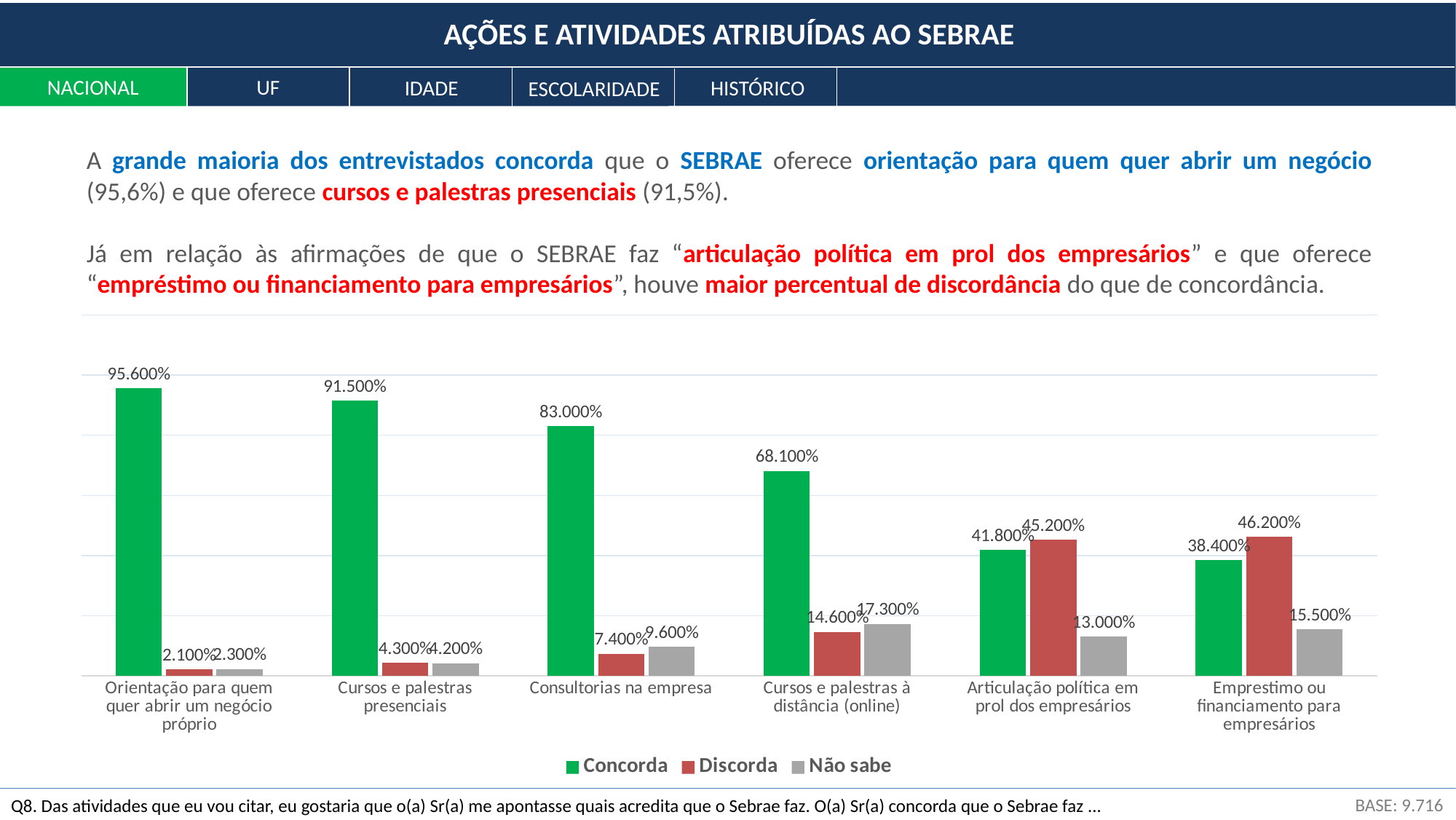
What is the Não sabe value for "Cursos e palestras à distância (online)"? 17.300% Which category has the highest Concorda value? Orientação para quem quer abrir um negócio próprio How many series does the legend list? 3 For "Articulação política em prol dos empresários", which is larger: the Concorda value or the Discorda value? Discorda What is the Concorda value for "Consultorias na empresa"? 83.000% Which category has the lowest Concorda value? Emprestimo ou financiamento para empresários What is the Discorda value for "Emprestimo ou financiamento para empresários"? 46.200% What type of chart is shown on the slide? bar chart What is the difference between the Concorda values for "Orientação para quem quer abrir um negócio próprio" and "Cursos e palestras presenciais"? 4.100% How many categories are shown on the x axis of the chart? 6 Do the Concorda values rise or fall from left to right along the x axis? fall Which colour represents the Discorda series in the chart? red